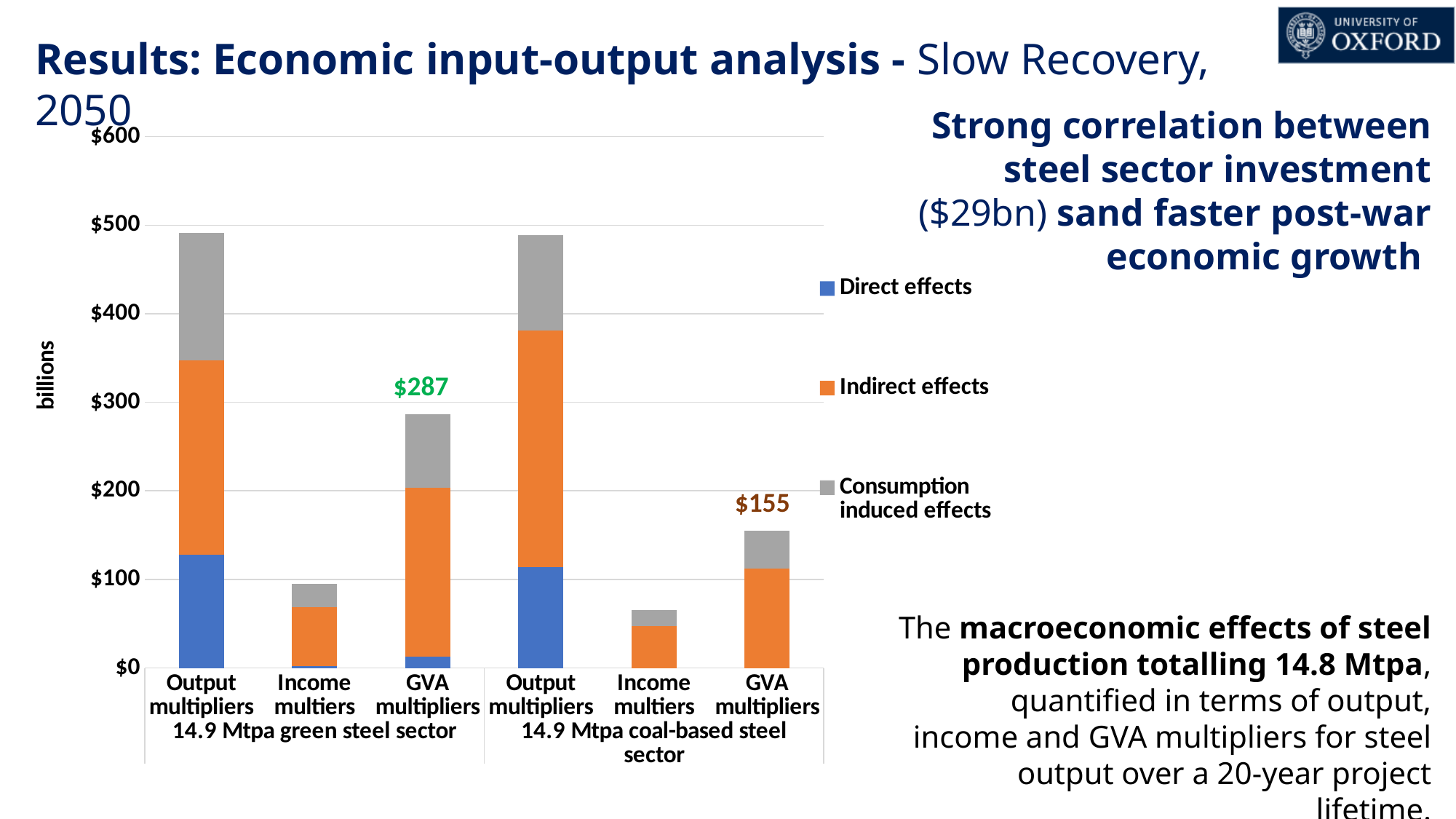
What is the difference between the GVA multipliers total for the green steel sector and the coal-based steel sector? $132 How many bars (categories) are plotted in the chart? 6 Is the total for Income multiers in the coal-based steel sector greater or less than $100? less What is the labelled total for GVA multipliers in the 14.9 Mtpa green steel sector? $287 How many series does the chart legend list? 3 Which bar has the lowest total in the chart? Income multiers, 14.9 Mtpa coal-based steel sector Which sector has the larger GVA multipliers total, green steel or coal-based steel? Green steel What is the labelled total for GVA multipliers in the 14.9 Mtpa coal-based steel sector? $155 What is the label on the vertical axis of the chart? billions Is the total for Income multiers in the green steel sector greater or less than $200? less Is the total for Output multipliers in the green steel sector greater or less than $400? greater What kind of chart is shown on the slide? Stacked bar chart